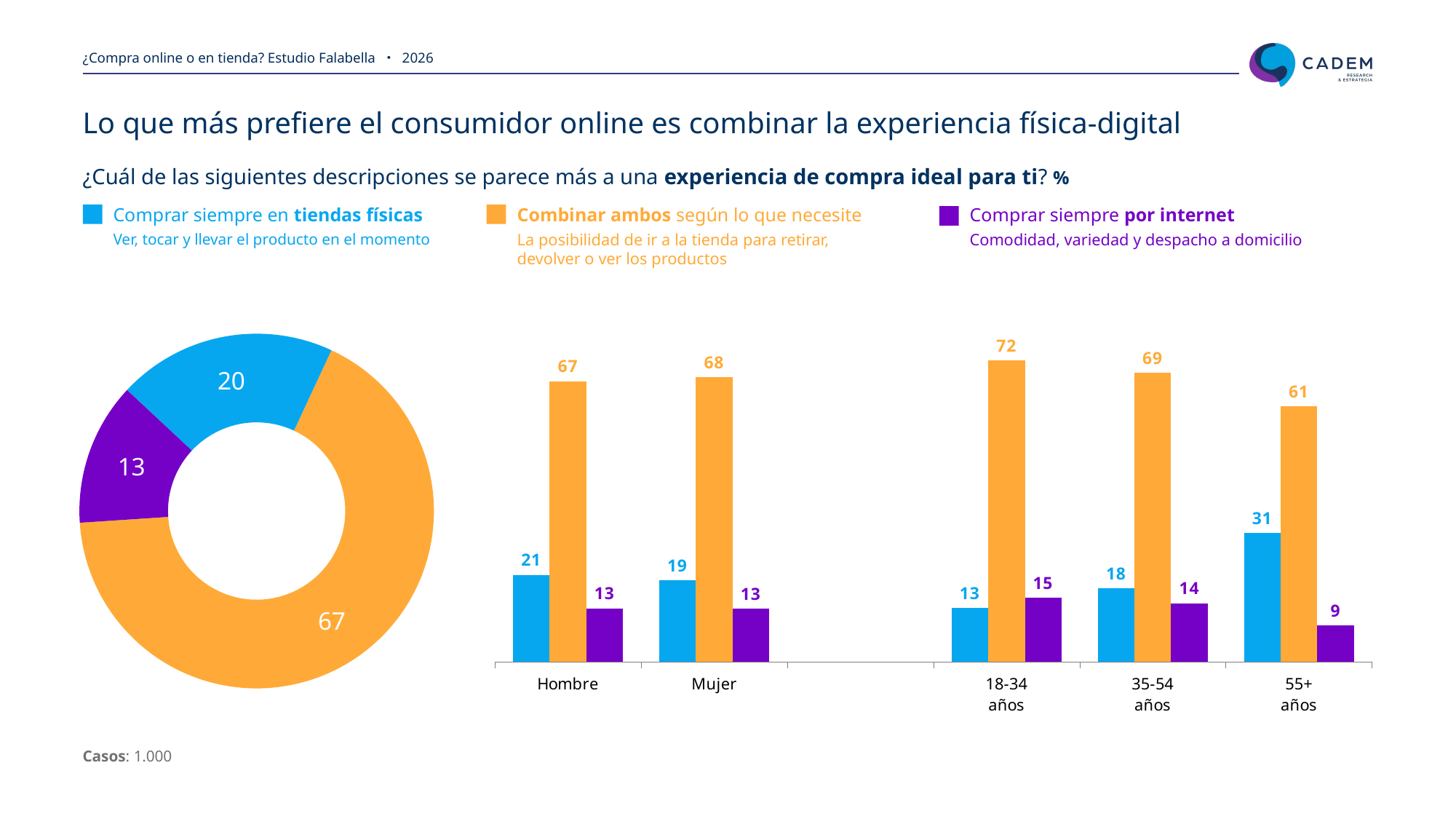
In the bar chart on the right, which group has the highest value for 'Combinar ambos'? 18-34 años In the bar chart on the right, is the value for 'Comprar siempre en tiendas físicas' larger for Hombre or for Mujer? Hombre What kind of chart is on the left of the slide? Donut (pie) chart How many series does the legend list? 3 In the bar chart on the right, what is the difference between 'Combinar ambos' for Hombre and for Mujer? 1 In the bar chart on the right, which group has the lowest value for 'Comprar siempre por internet'? 55+ años In the bar chart on the right, what is the value for 'Combinar ambos' among 18-34 años? 72 In the donut chart on the left, what is the value for 'Combinar ambos según lo que necesite'? 67 In the bar chart on the right, what is the value for 'Comprar siempre en tiendas físicas' among 55+ años? 31 In the donut chart on the left, which option has the smallest share? Comprar siempre por internet In the bar chart on the right, how many groups are shown on the x axis? 5 In the donut chart on the left, what is the difference between 'Comprar siempre en tiendas físicas' and 'Comprar siempre por internet'? 7